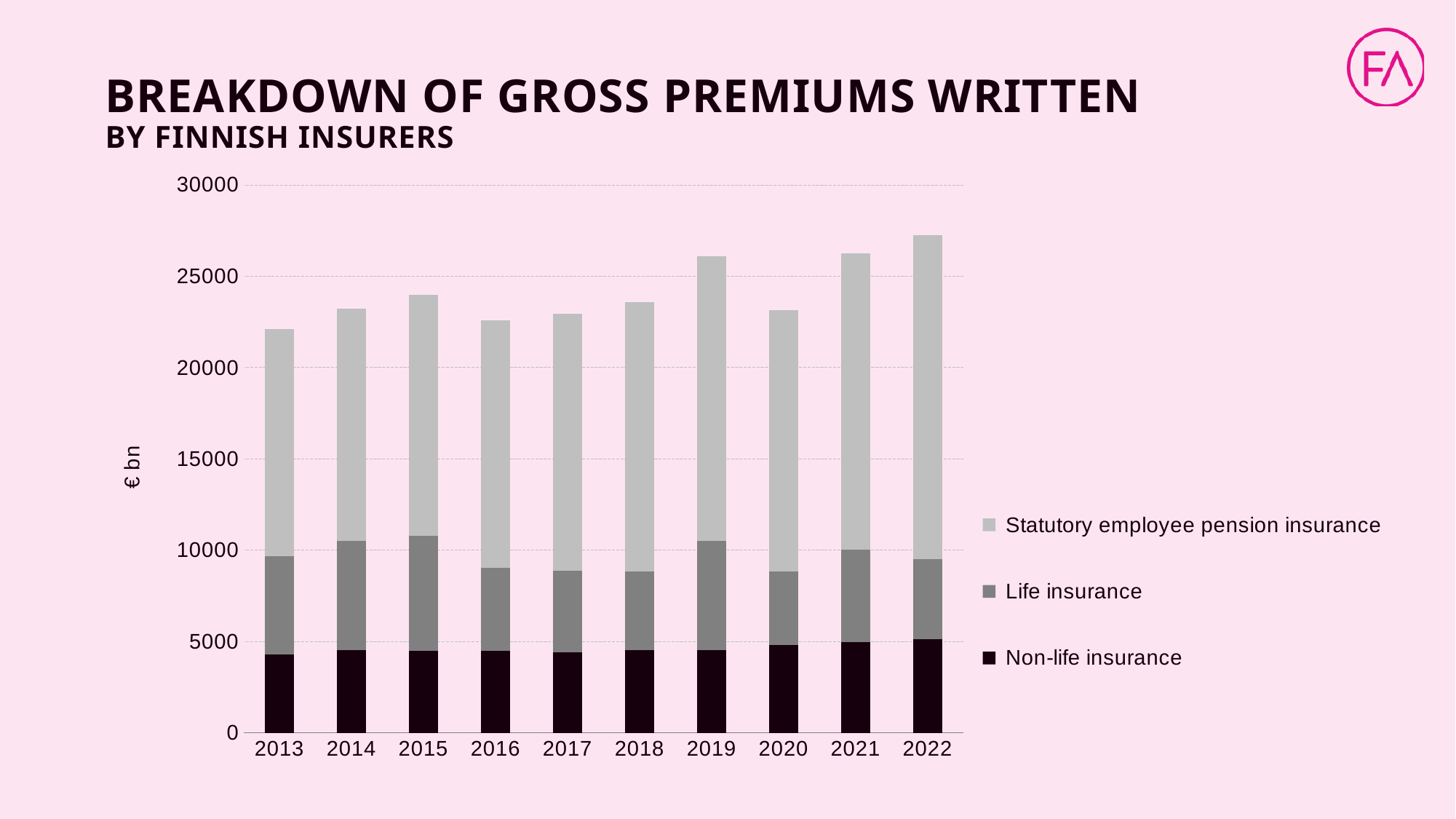
How many years are shown on the x axis of the chart? 10 Is the total for 2013 greater or less than 25000? less Is the total for 2020 greater or less than 25000? less What is the label on the vertical axis of the chart? € bn How many series does the legend list? 3 Which year has the highest total gross premiums written? 2022 Which year has the larger total, 2013 or 2022? 2022 What kind of chart is shown on the slide? Stacked bar chart Which year has the larger total, 2019 or 2020? 2019 Is the Non-life insurance value for 2013 greater or less than 5000? less Which series is shown as the bottom (black) segment of each bar? Non-life insurance